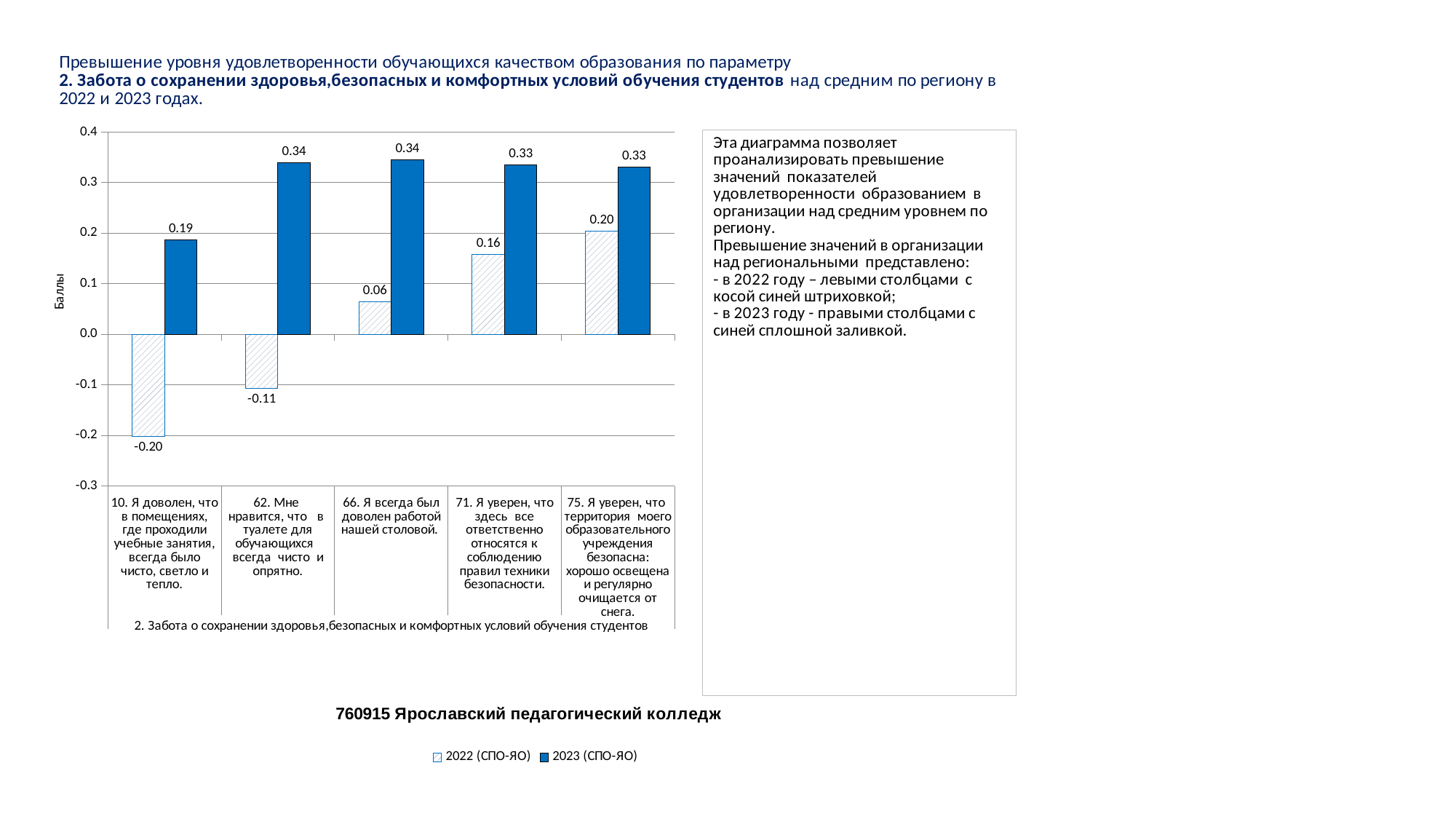
Which item has the lowest 2022 (СПО-ЯО) value? 10. Я доволен, что в помещениях, где проходили учебные занятия, всегда было чисто, светло и тепло. Which item has the highest 2022 (СПО-ЯО) value? 75. Я уверен, что территория моего образовательного учреждения безопасна: хорошо освещена и регулярно очищается от снега. How many series does the legend list? 2 Which is larger: the 2022 (СПО-ЯО) value for item 71 or for item 75? item 75 What is the difference between the 2023 and 2022 values for item 75 (Я уверен, что территория моего образовательного учреждения безопасна)? 0.13 What is the 2022 (СПО-ЯО) value for item 10 (Я доволен, что в помещениях, где проходили учебные занятия, всегда было чисто, светло и тепло)? -0.20 What is the 2022 (СПО-ЯО) value for item 66 (Я всегда был доволен работой нашей столовой)? 0.06 Do the 2022 (СПО-ЯО) values rise or fall from item 10 to item 75 along the x axis? rise How many categories (survey items) are shown on the x axis? 5 What is the 2023 (СПО-ЯО) value for item 62 (Мне нравится, что в туалете для обучающихся всегда чисто и опрятно)? 0.34 What kind of chart is shown on the slide? bar chart Which item has the lowest 2023 (СПО-ЯО) value? 10. Я доволен, что в помещениях, где проходили учебные занятия, всегда было чисто, светло и тепло.